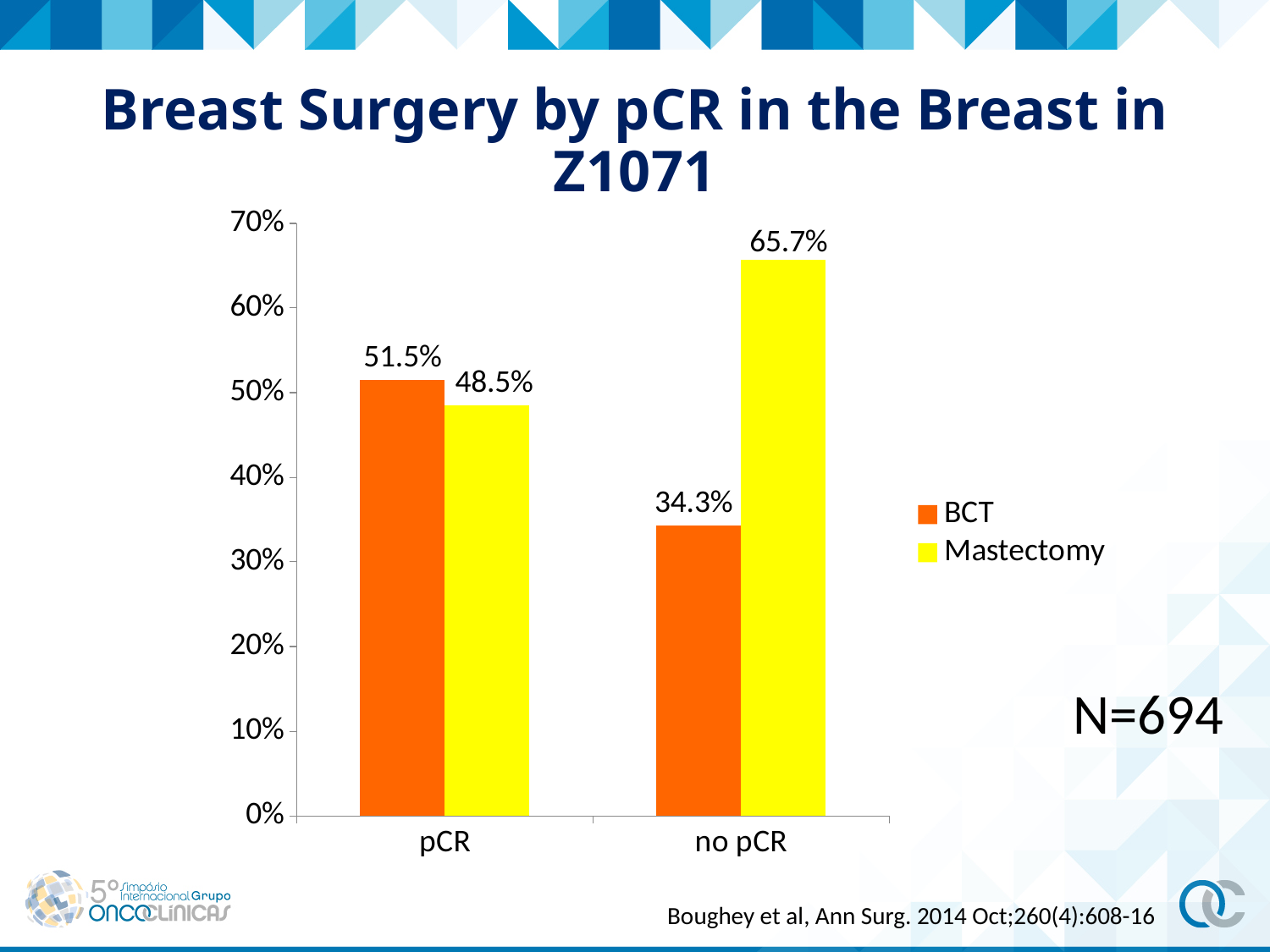
What is the BCT value for the pCR group? 51.5% What kind of chart is shown on the slide? bar chart How many groups are shown on the x axis? 2 What is the BCT value for the no pCR group? 34.3% What is the Mastectomy value for the no pCR group? 65.7% Which group has the lowest BCT value? no pCR What is the Mastectomy value for the pCR group? 48.5% How many series does the legend list? 2 In the pCR group, which is larger, BCT or Mastectomy? BCT What is the difference between the Mastectomy and BCT values in the no pCR group? 31.4% Which group has the highest Mastectomy value? no pCR Is the BCT value for the no pCR group greater or less than 40%? less